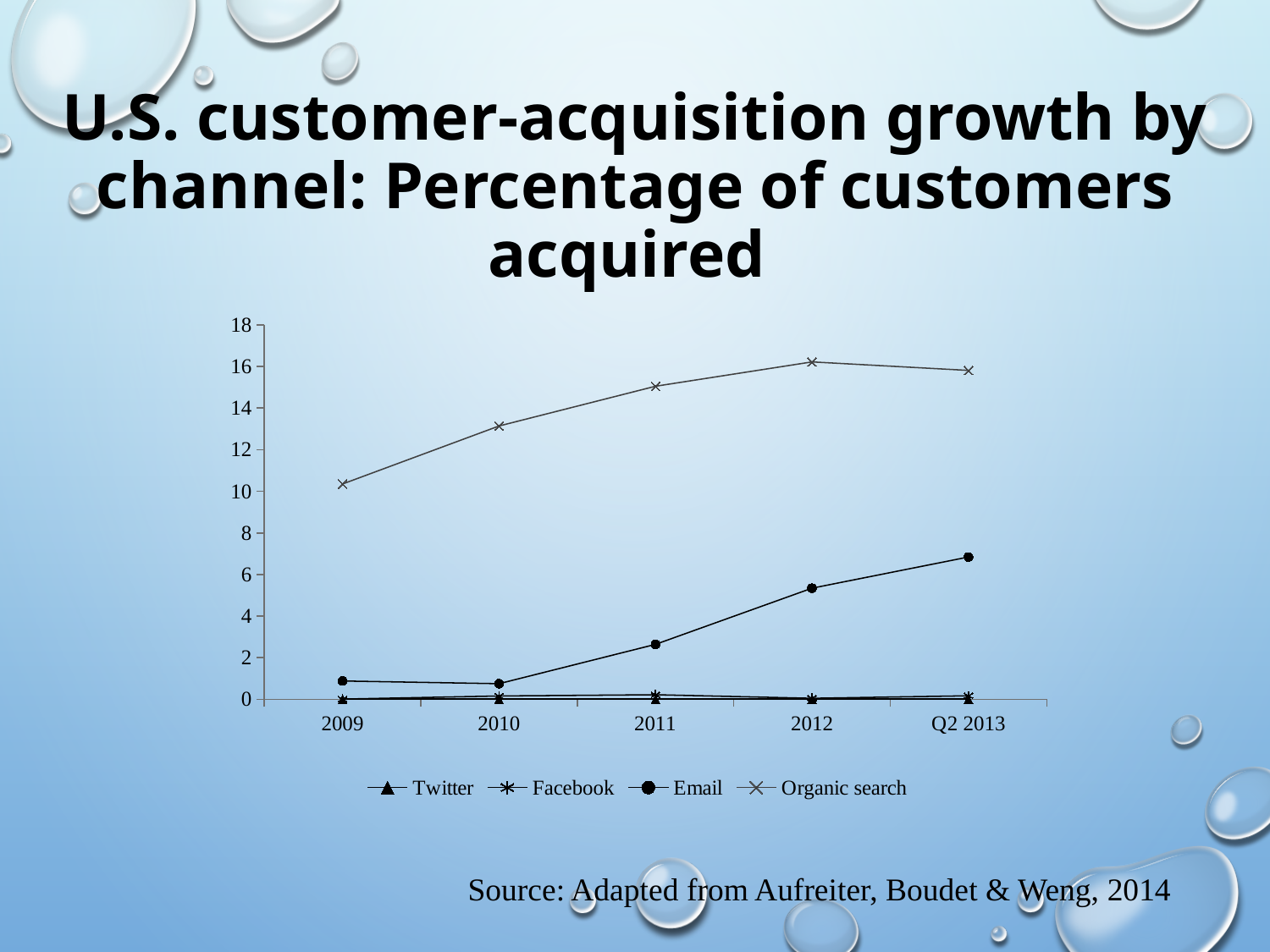
Which series has the highest value in 2012? Organic search How many series does the legend list? 4 How many time points are plotted along the x axis? 5 Is the value for Email in 2011 greater or less than 4? less Does the Email series rise or fall from 2010 to Q2 2013? rise What is the last time point labelled on the x axis? Q2 2013 Is the value for Email in Q2 2013 greater or less than 6? greater Which is larger in 2010, the value for Email or the value for Organic search? Organic search What kind of chart is shown on the slide? line chart Which series is plotted with circle markers? Email